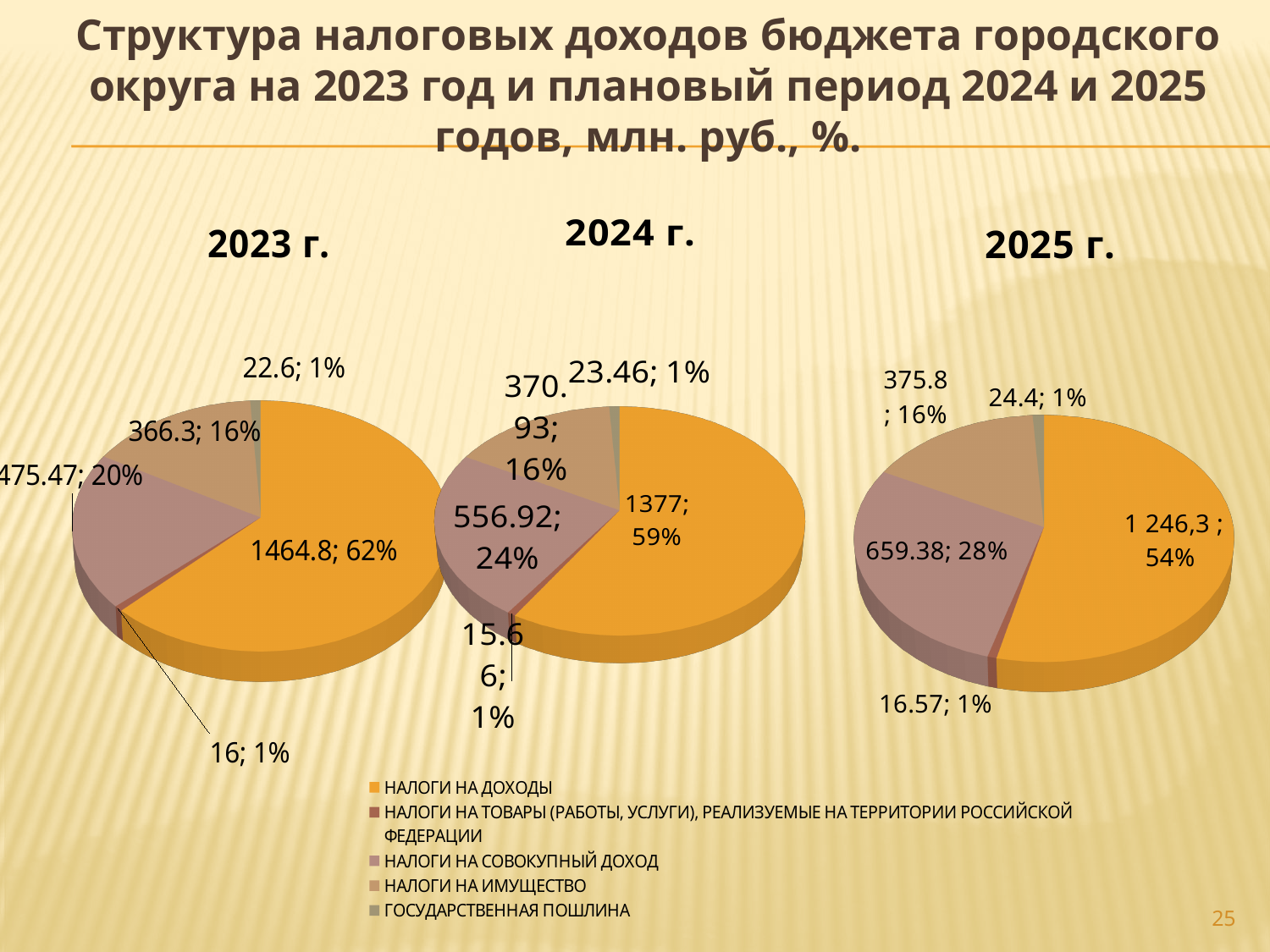
In the 2024 г. pie chart, which category has the largest slice? НАЛОГИ НА ДОХОДЫ In the 2025 г. pie chart, which is larger: НАЛОГИ НА СОВОКУПНЫЙ ДОХОД or НАЛОГИ НА ИМУЩЕСТВО? НАЛОГИ НА СОВОКУПНЫЙ ДОХОД In the 2024 г. pie chart, what is the value shown for НАЛОГИ НА СОВОКУПНЫЙ ДОХОД? 556.92; 24% In the 2023 г. pie chart, what is the difference between the values for НАЛОГИ НА СОВОКУПНЫЙ ДОХОД and НАЛОГИ НА ИМУЩЕСТВО? 109.17 In the 2023 г. pie chart, what is the value shown for НАЛОГИ НА ДОХОДЫ? 1464.8; 62% In the 2023 г. pie chart, which category has the smallest value? НАЛОГИ НА ТОВАРЫ (РАБОТЫ, УСЛУГИ), РЕАЛИЗУЕМЫЕ НА ТЕРРИТОРИИ РОССИЙСКОЙ ФЕДЕРАЦИИ What kind of charts are shown on the slide? Pie charts In the 2025 г. pie chart, what is the value shown for НАЛОГИ НА ИМУЩЕСТВО? 375.8; 16% How many slices does the 2024 г. pie chart have? 5 In the 2025 г. pie chart, what share of the pie does НАЛОГИ НА ДОХОДЫ take? 54% How many entries does the legend list? 5 In the 2024 г. pie chart, what is the value shown for ГОСУДАРСТВЕННАЯ ПОШЛИНА? 23.46; 1%